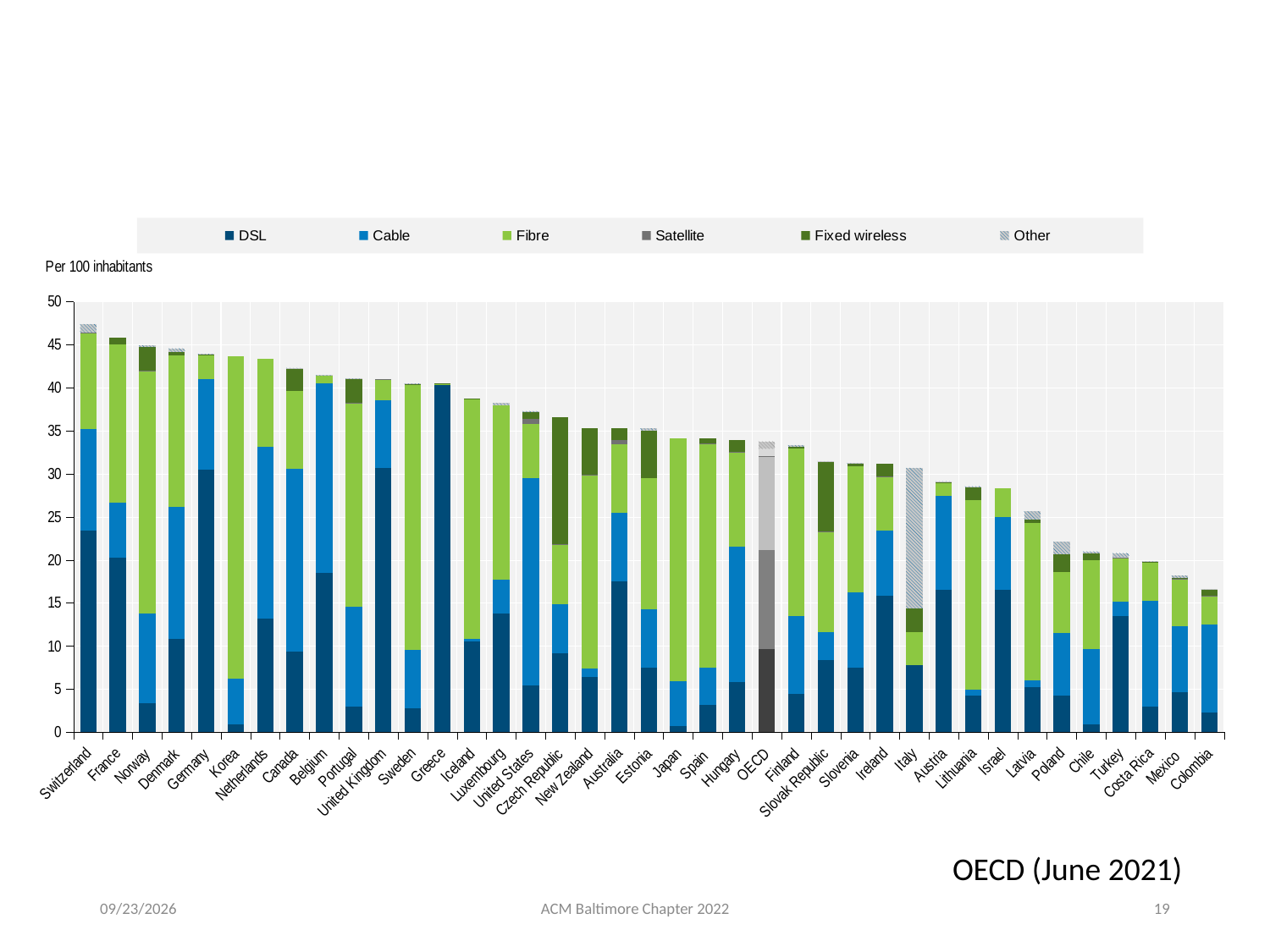
Do the total bar heights generally rise or fall from left to right along the x axis? fall How many series does the legend list? 6 What unit is stated above the y axis of the chart? Per 100 inhabitants Which has the larger DSL segment, Greece or Korea? Greece Which category has the lowest total bar? Colombia Is the total value for Colombia greater or less than 20? less Which category has the highest total bar? Switzerland What kind of chart is shown on the slide? Stacked bar chart Is the total value for Germany greater or less than 40? greater How many countries/categories are shown along the x axis? 39 Is the total value for Switzerland greater or less than 45? greater